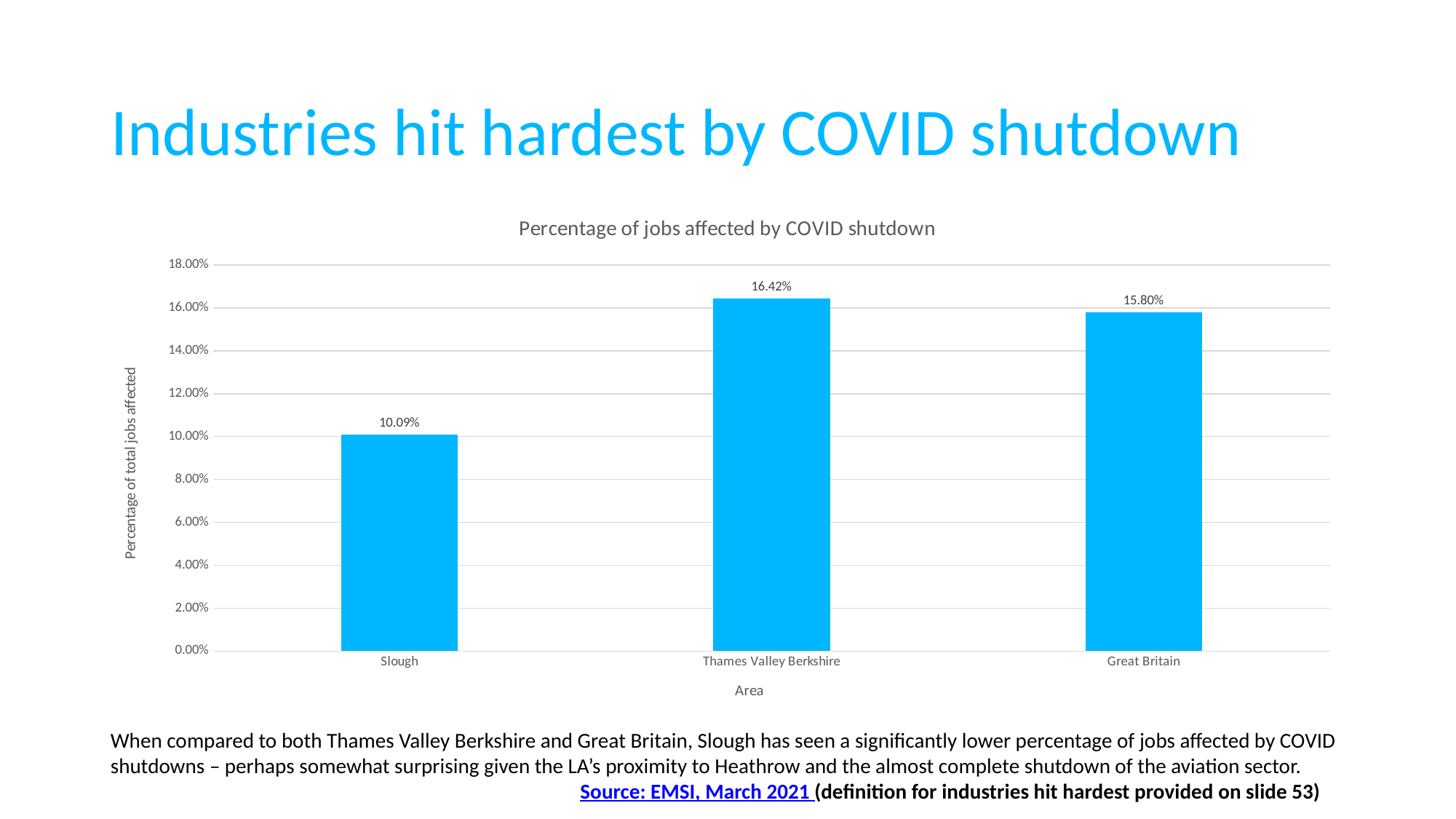
How many areas are shown in the chart? 3 What is the percentage of jobs affected by COVID shutdown for Thames Valley Berkshire? 16.42% What type of chart is shown on the slide? Bar chart Which area has the highest percentage of jobs affected by COVID shutdown? Thames Valley Berkshire Which area has the lowest percentage of jobs affected by COVID shutdown? Slough What is the percentage of jobs affected by COVID shutdown for Great Britain? 15.80% What is the percentage of jobs affected by COVID shutdown for Slough? 10.09% Which has a higher percentage of jobs affected: Slough or Great Britain? Great Britain What is the title of the chart? Percentage of jobs affected by COVID shutdown What is the difference in percentage points between Thames Valley Berkshire and Great Britain? 0.62 Is the value for Slough greater or less than 12.00%? less What is the difference in percentage points between Thames Valley Berkshire and Slough? 6.33